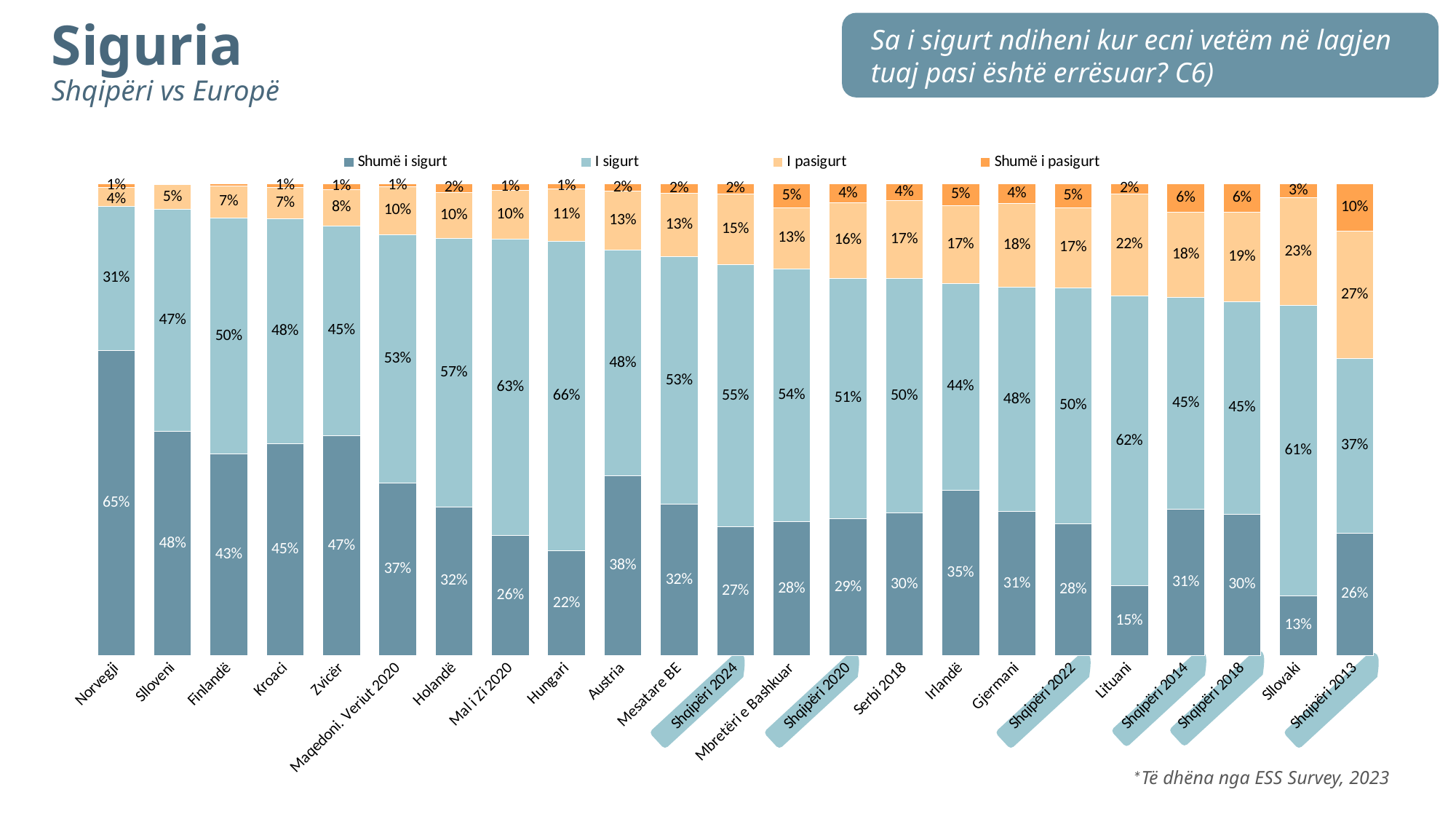
What type of chart is shown on the slide? stacked bar chart What is the 'I pasigurt' value for Lituani? 22% Which category has the highest 'I pasigurt' value? Shqipëri 2013 What is the 'I sigurt' value for Hungari? 66% Which category has the lowest 'Shumë i sigurt' value? Sllovaki How many series does the legend list? 4 Which is larger: the 'I sigurt' value for Mal i Zi 2020 or for Mesatare BE? Mal i Zi 2020 Which category has the highest 'Shumë i sigurt' value? Norvegji What is the 'Shumë i pasigurt' value for Shqipëri 2013? 10% What is the 'Shumë i sigurt' value for Norvegji? 65% What is the difference between the 'Shumë i sigurt' values for Shqipëri 2024 and Shqipëri 2013? 1% How many categories are shown on the x axis? 23